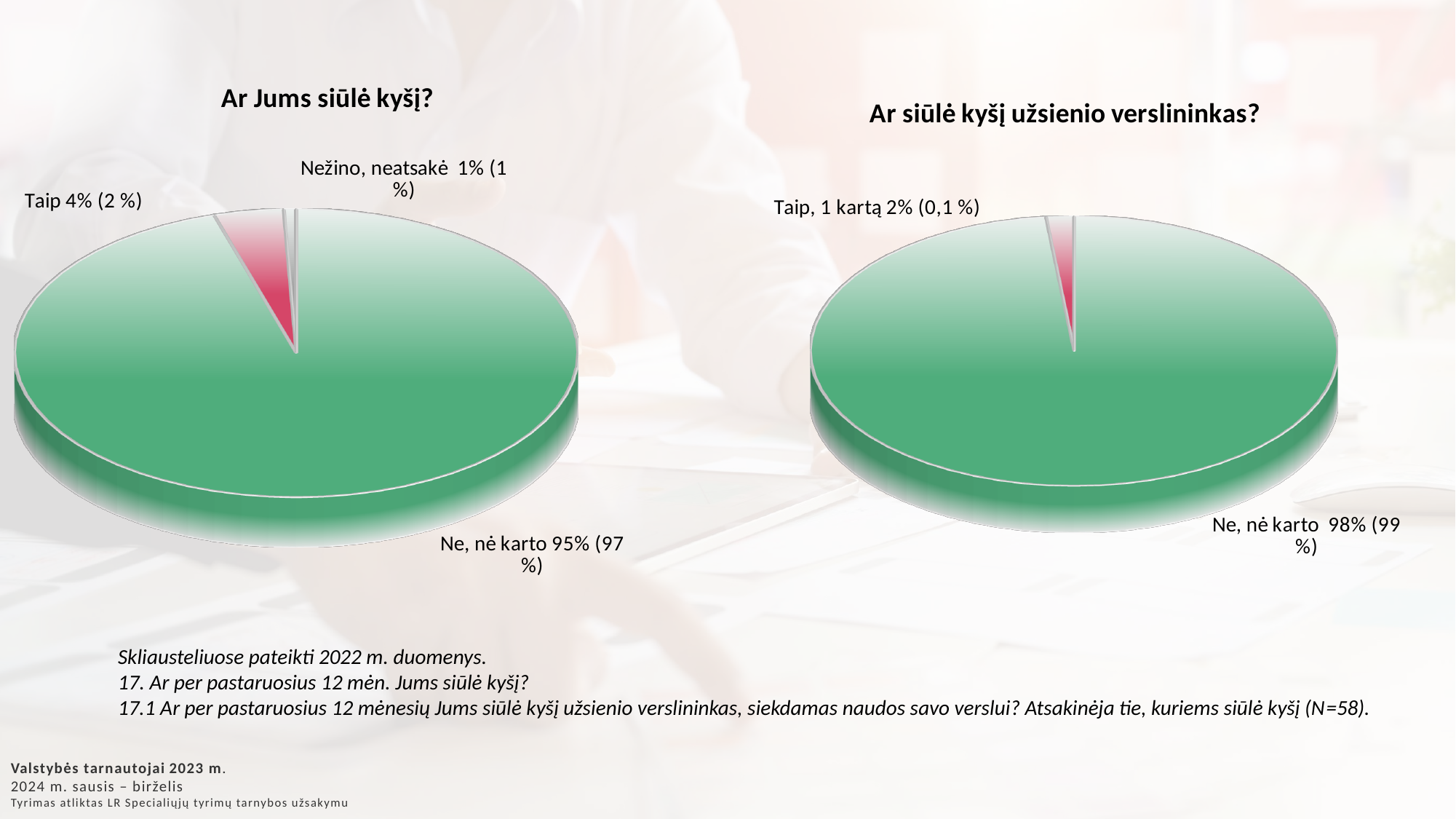
In the chart "Ar Jums siūlė kyšį?", what is the difference between the "Ne, nė karto" share and the "Taip" share? 91% In the chart "Ar siūlė kyšį užsienio verslininkas?", what share does "Ne, nė karto" have? 98% How many slices does the chart "Ar siūlė kyšį užsienio verslininkas?" have? 2 In the chart "Ar Jums siūlė kyšį?", what share does "Taip" have? 4% How many slices does the chart "Ar Jums siūlė kyšį?" have? 3 In the chart "Ar Jums siūlė kyšį?", what 2022 value is shown in parentheses for "Ne, nė karto"? 97 % In the chart "Ar Jums siūlė kyšį?", what share does "Ne, nė karto" have? 95% In the chart "Ar Jums siūlė kyšį?", which slice is the largest? Ne, nė karto In the chart "Ar Jums siūlė kyšį?", which slice is the smallest? Nežino, neatsakė What kind of chart is used for "Ar Jums siūlė kyšį?"? pie chart